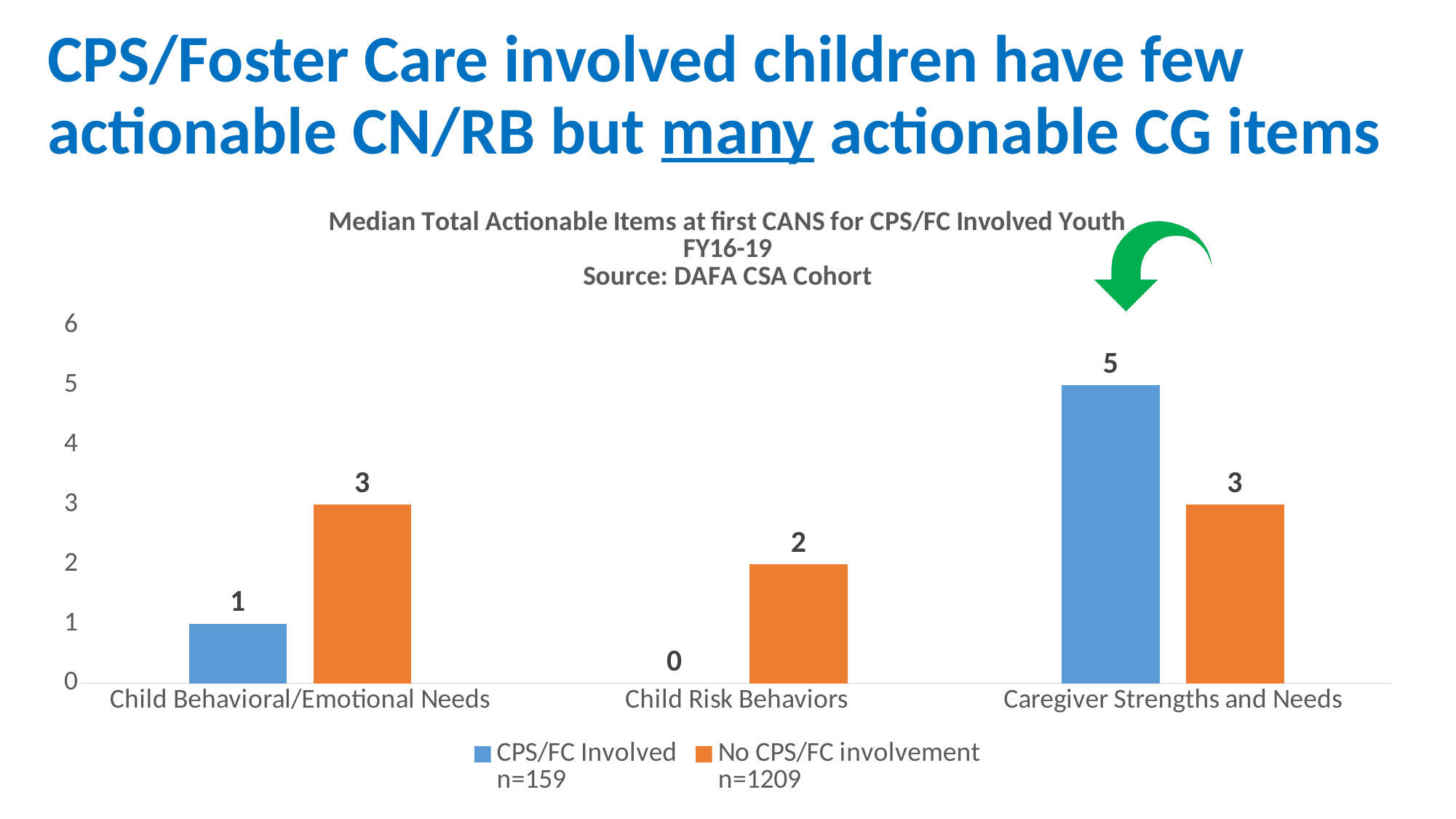
How many series does the legend list? 2 What is the difference between the CPS/FC Involved and No CPS/FC involvement values for Caregiver Strengths and Needs? 2 What is the value for CPS/FC Involved in the Caregiver Strengths and Needs category? 5 What is the sample size (n) for the CPS/FC Involved series shown in the legend? n=159 What kind of chart is shown on the slide? Bar chart For Child Behavioral/Emotional Needs, which series has the larger value: CPS/FC Involved or No CPS/FC involvement? No CPS/FC involvement How many categories are shown on the x axis? 3 What is the value for CPS/FC Involved in the Child Risk Behaviors category? 0 What is the value for No CPS/FC involvement in the Child Risk Behaviors category? 2 What is the value for CPS/FC Involved in the Child Behavioral/Emotional Needs category? 1 In which category is the CPS/FC Involved value lowest? Child Risk Behaviors In which category is the CPS/FC Involved value highest? Caregiver Strengths and Needs